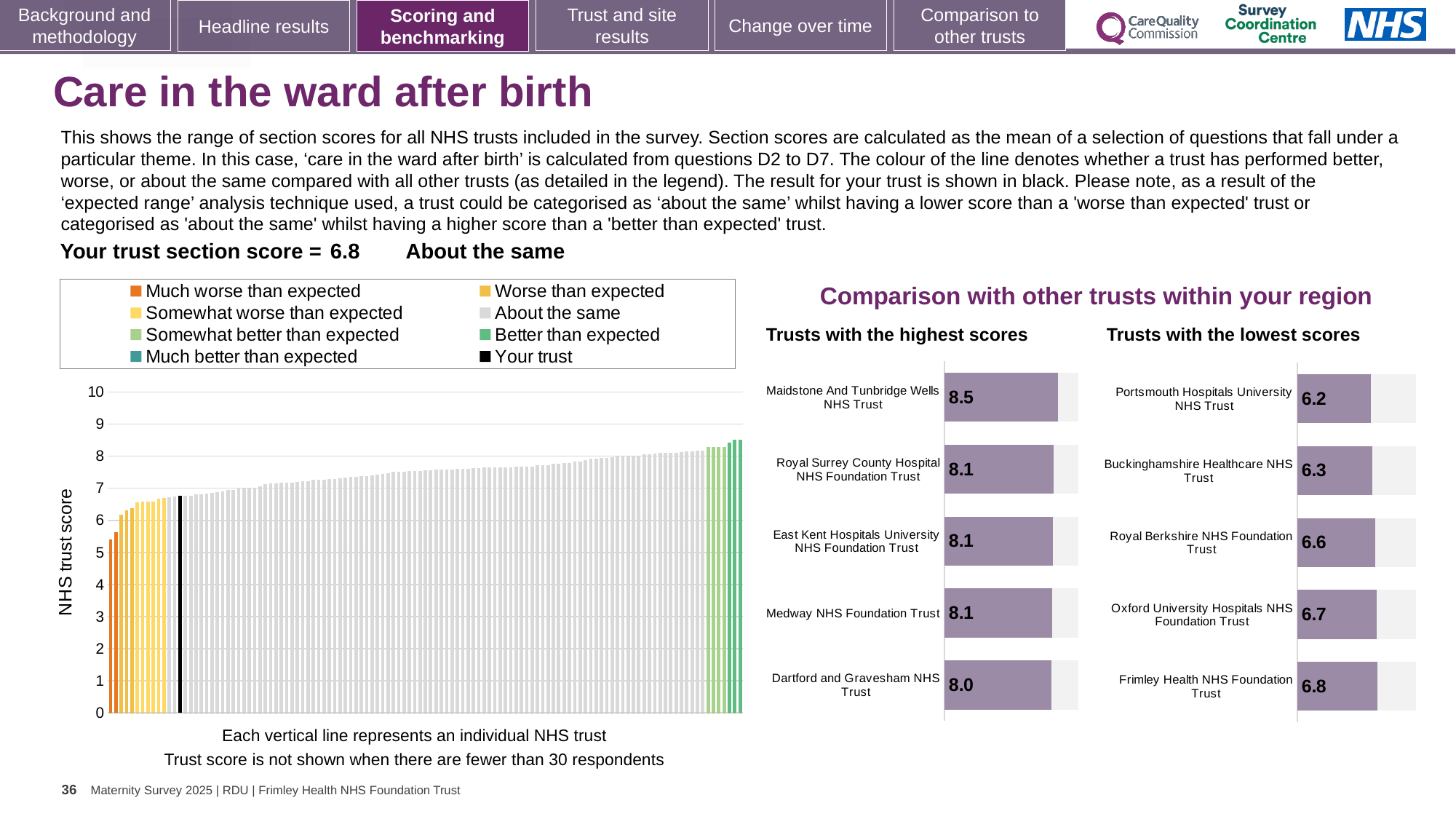
What kind of chart is the main chart on the left with the 'NHS trust score' axis? Bar chart In the 'Trusts with the lowest scores' chart, what is the score for Frimley Health NHS Foundation Trust? 6.8 In the 'Trusts with the lowest scores' chart, which has the higher score: Royal Berkshire NHS Foundation Trust or Oxford University Hospitals NHS Foundation Trust? Oxford University Hospitals NHS Foundation Trust In the 'Trusts with the highest scores' chart, which trust has the highest score? Maidstone And Tunbridge Wells NHS Trust In the 'Trusts with the lowest scores' chart, what is the score for Portsmouth Hospitals University NHS Trust? 6.2 In the 'Trusts with the lowest scores' chart, which trust has the lowest score? Portsmouth Hospitals University NHS Trust How many trusts are shown in the 'Trusts with the highest scores' chart? 5 How many entries does the legend of the main 'NHS trust score' chart list? 8 In the 'Trusts with the highest scores' chart, what is the score for Maidstone And Tunbridge Wells NHS Trust? 8.5 In the main 'NHS trust score' chart, do the values rise or fall from left to right? Rise What is the title of the section containing the two small bar charts on the right? Comparison with other trusts within your region In the 'Trusts with the highest scores' chart, what is the difference between the scores of Maidstone And Tunbridge Wells NHS Trust and Dartford and Gravesham NHS Trust? 0.5